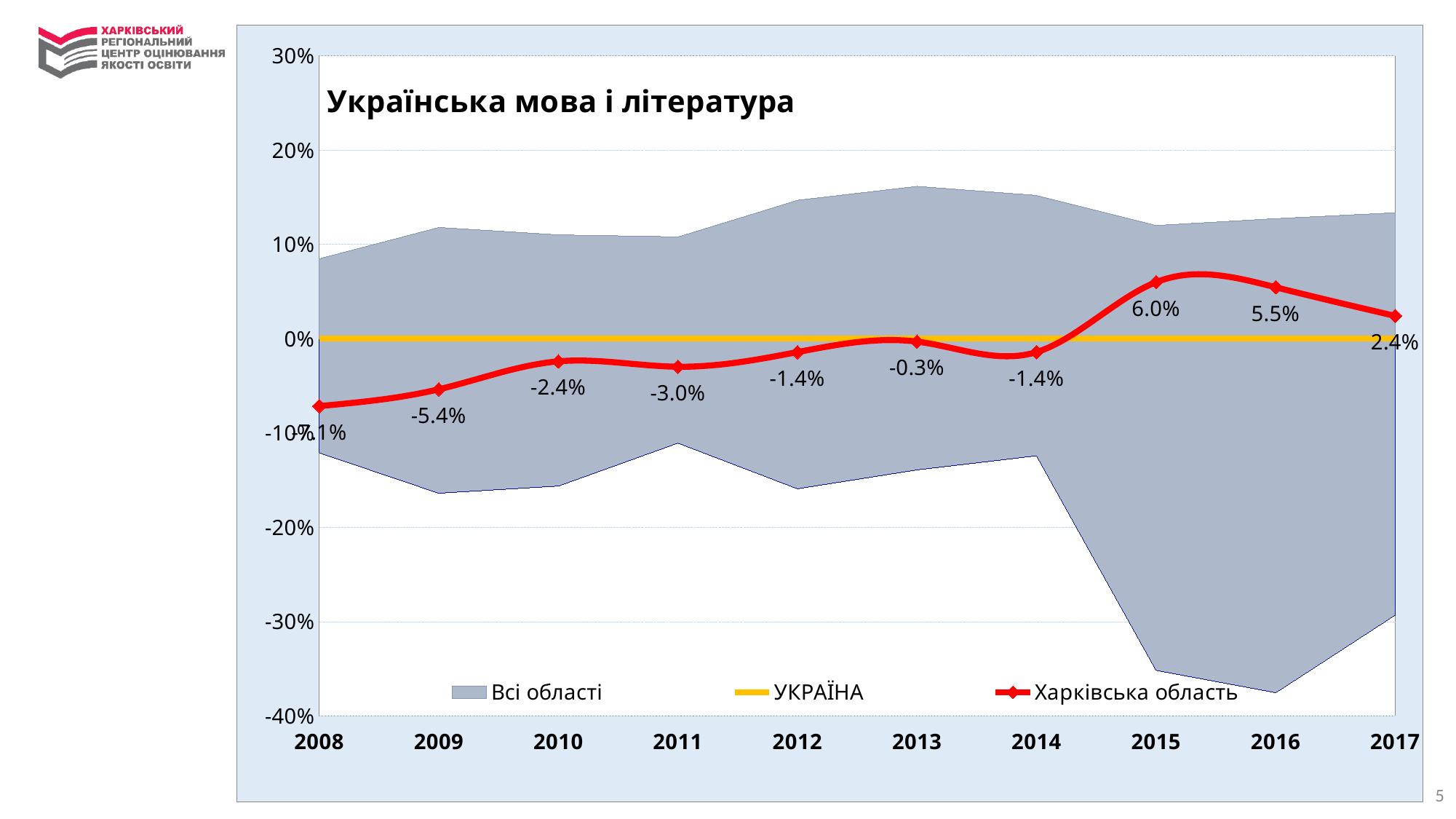
What is the value for Харківська область in 2013? -0.3% How many years are shown on the x axis? 10 What is the value for Харківська область in 2017? 2.4% Which is larger for Харківська область: the value in 2010 or in 2011? 2010 How many series does the legend list? 3 What is the difference between the Харківська область values in 2015 and 2016? 0.5 percentage points In which year is the value for Харківська область lowest? 2008 Does the Харківська область line rise or fall from 2008 to 2015? rise What is the value for Харківська область in 2009? -5.4% What is the value for Харківська область in 2015? 6.0% Is the value for Харківська область in 2012 greater or less than 0%? less In which year is the value for Харківська область highest? 2015